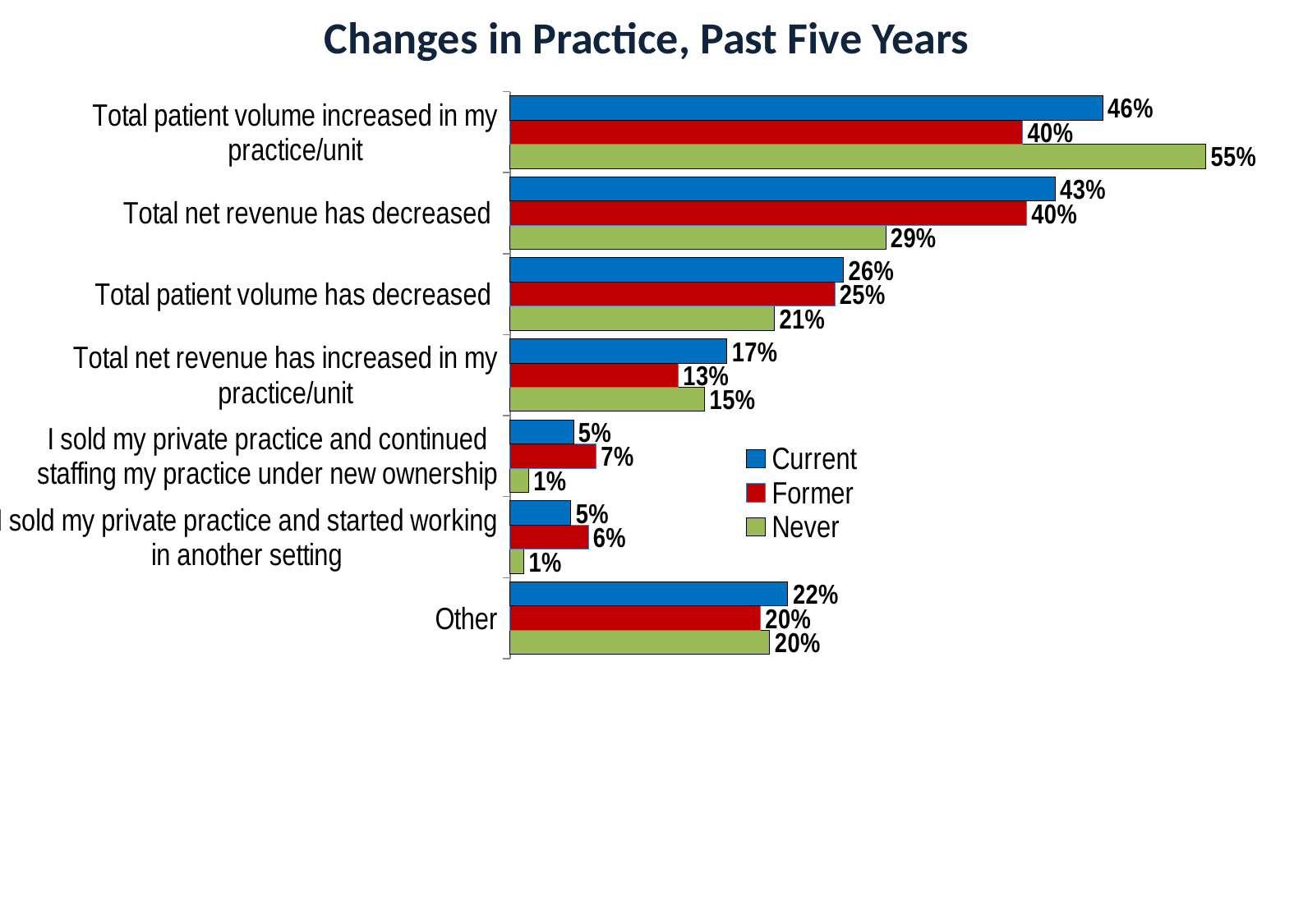
What is the Never value for "Total patient volume increased in my practice/unit"? 55% For "Total patient volume has decreased", which is larger, the Current value or the Never value? Current Which category has the highest Never value? Total patient volume increased in my practice/unit What kind of chart is shown on the slide? Bar chart What is the Current value for "Total net revenue has decreased"? 43% For "I sold my private practice and continued staffing my practice under new ownership", which is larger, the Former value or the Current value? Former How many categories are shown on the chart? 7 How many series does the legend list? 3 Which category has the lowest Current value? I sold my private practice and continued staffing my practice under new ownership (tied with I sold my private practice and started working in another setting, both 5%) What is the difference between the Never and Current values for "Total patient volume increased in my practice/unit"? 9% What is the difference between the Current and Never values for "Total net revenue has decreased"? 14% What is the Former value for "Total net revenue has increased in my practice/unit"? 13%